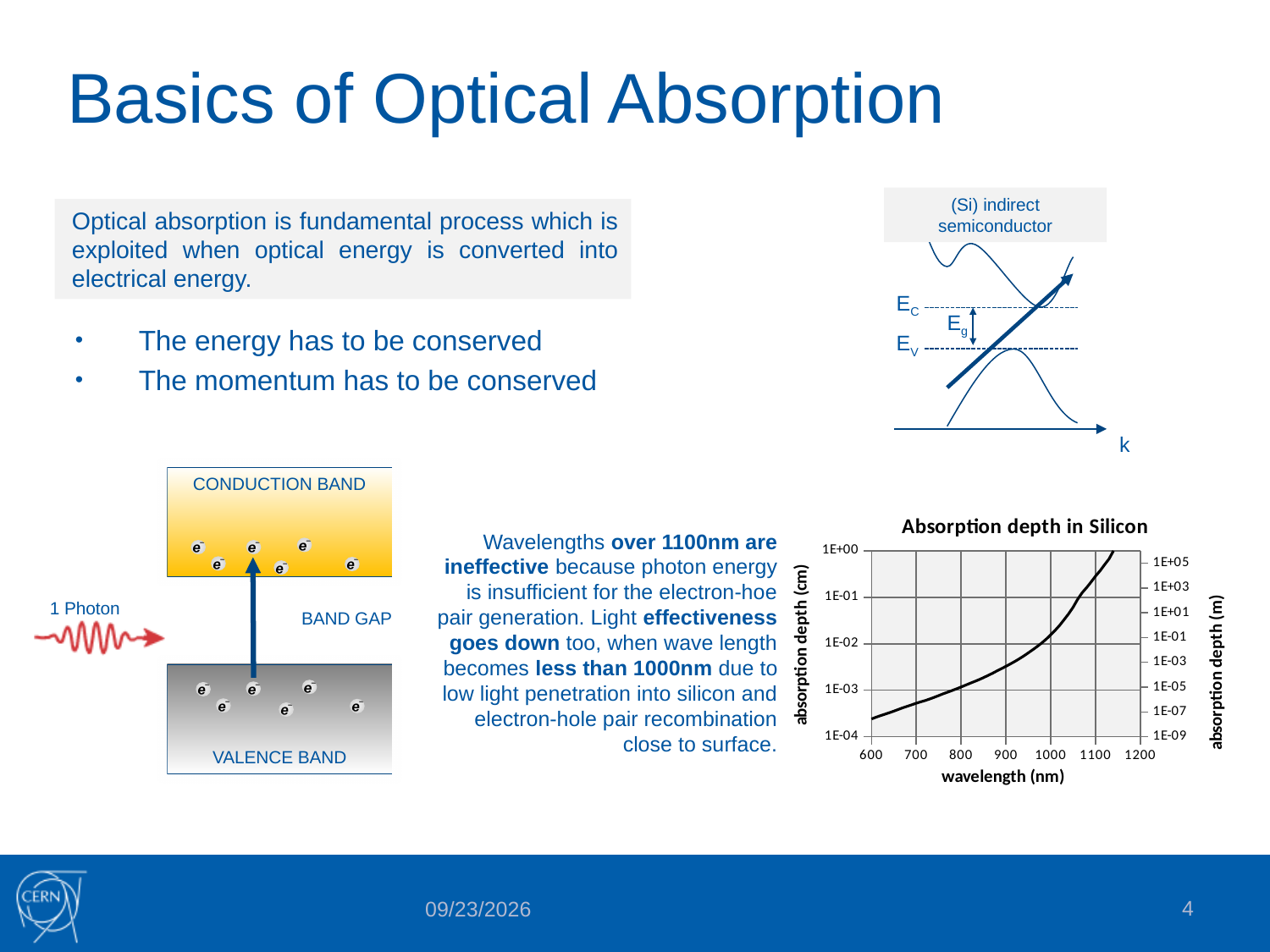
In the 'Absorption depth in Silicon' chart, is the absorption depth (cm) at 900 nm greater or less than 1E-02? less What is the title of the chart on the slide? Absorption depth in Silicon In the 'Absorption depth in Silicon' chart, is the absorption depth (cm) at 700 nm greater or less than 1E-03? less What type of chart is 'Absorption depth in Silicon'? line chart How many data series are plotted in the 'Absorption depth in Silicon' chart? 1 In the 'Absorption depth in Silicon' chart, does the absorption depth rise or fall as wavelength increases? rise How many wavelength tick labels are shown on the x axis of the 'Absorption depth in Silicon' chart? 7 In the 'Absorption depth in Silicon' chart, is the absorption depth (cm) at 1100 nm greater or less than 1E-01? greater In the 'Absorption depth in Silicon' chart, which wavelength has the higher absorption depth, 700 nm or 1100 nm? 1100 nm What is the label of the left vertical axis of the 'Absorption depth in Silicon' chart? absorption depth (cm)